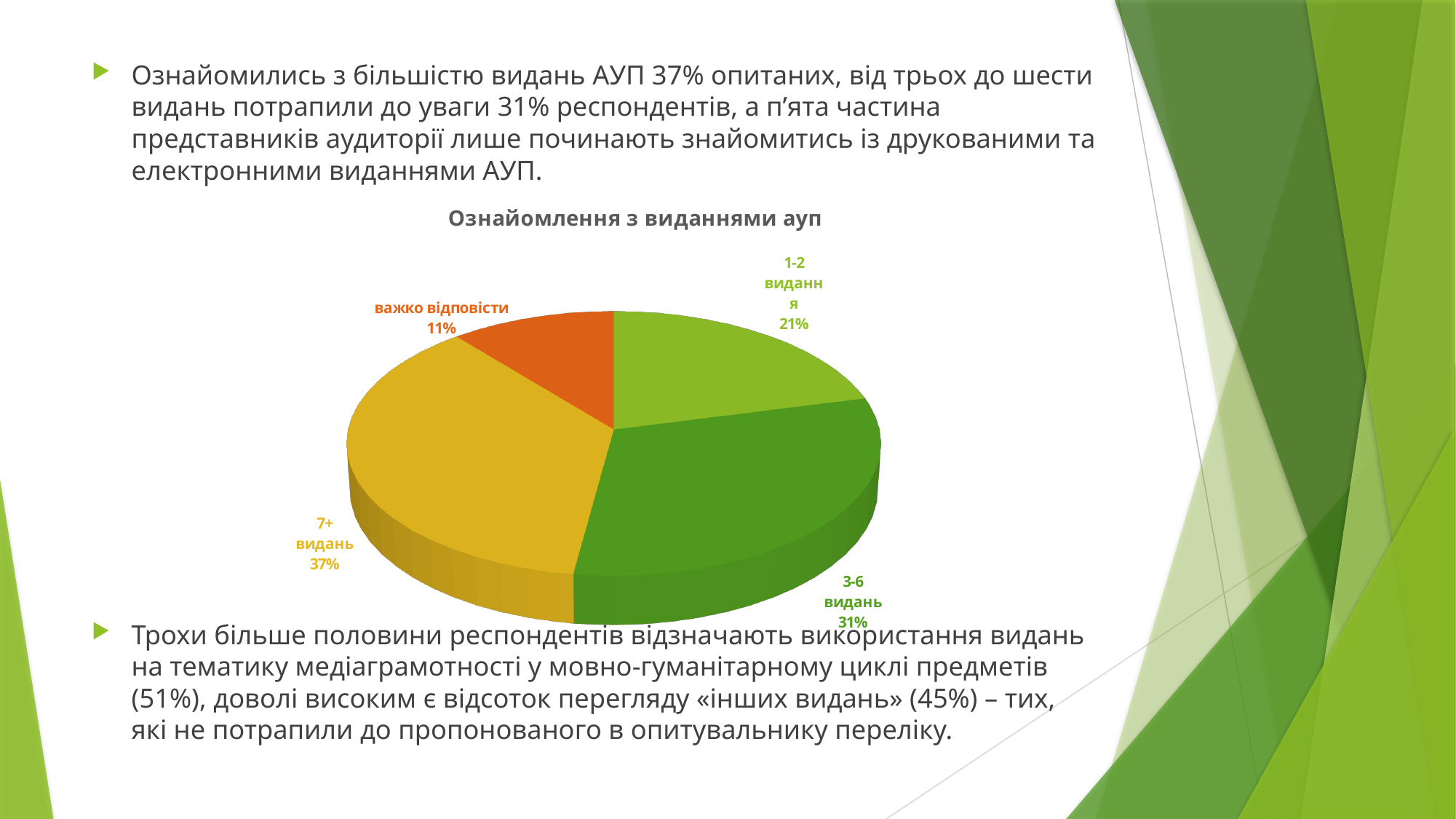
Which slice is larger: "3-6 видань" or "1-2 видання"? 3-6 видань How many slices does the pie chart have? 4 What share of the pie does the "3-6 видань" slice represent? 31% What share of the pie does the "важко відповісти" slice represent? 11% What share of the pie does the "7+ видань" slice represent? 37% Which category has the smallest slice of the pie? важко відповісти Which category has the largest slice of the pie? 7+ видань What colour is the "важко відповісти" slice? Orange What is the title of the chart? Ознайомлення з виданнями ауп What is the difference in percentage points between the "7+ видань" and "1-2 видання" slices? 16 What kind of chart is shown on the slide? Pie chart